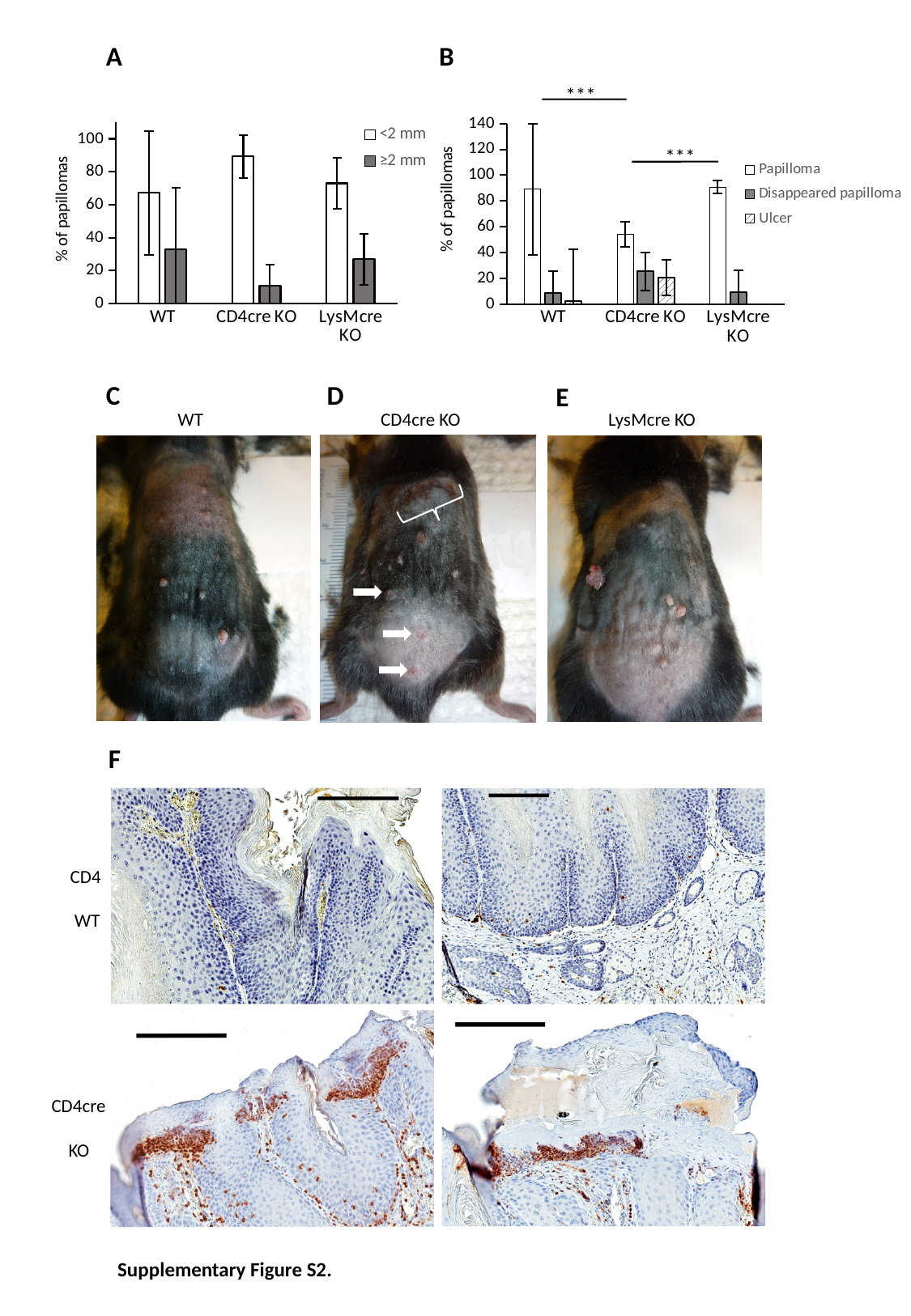
In chart A, is the ≥2 mm value for WT greater or less than 20? greater In chart A, which category has the highest <2 mm bar? CD4cre KO In chart A, is the <2 mm value for CD4cre KO greater or less than 80? greater In chart B, which category has the lowest Papilloma bar? CD4cre KO How many categories are shown on the x axis of chart A? 3 In chart B, is the Papilloma value for CD4cre KO greater or less than 80? less In chart A, which is larger, the <2 mm value for WT or for CD4cre KO? CD4cre KO How many series does the legend of chart B list? 3 In chart A, which category has the lowest ≥2 mm bar? CD4cre KO What kind of chart is chart A? bar chart What is the y-axis label of chart B? % of papillomas How many series does the legend of chart A list? 2